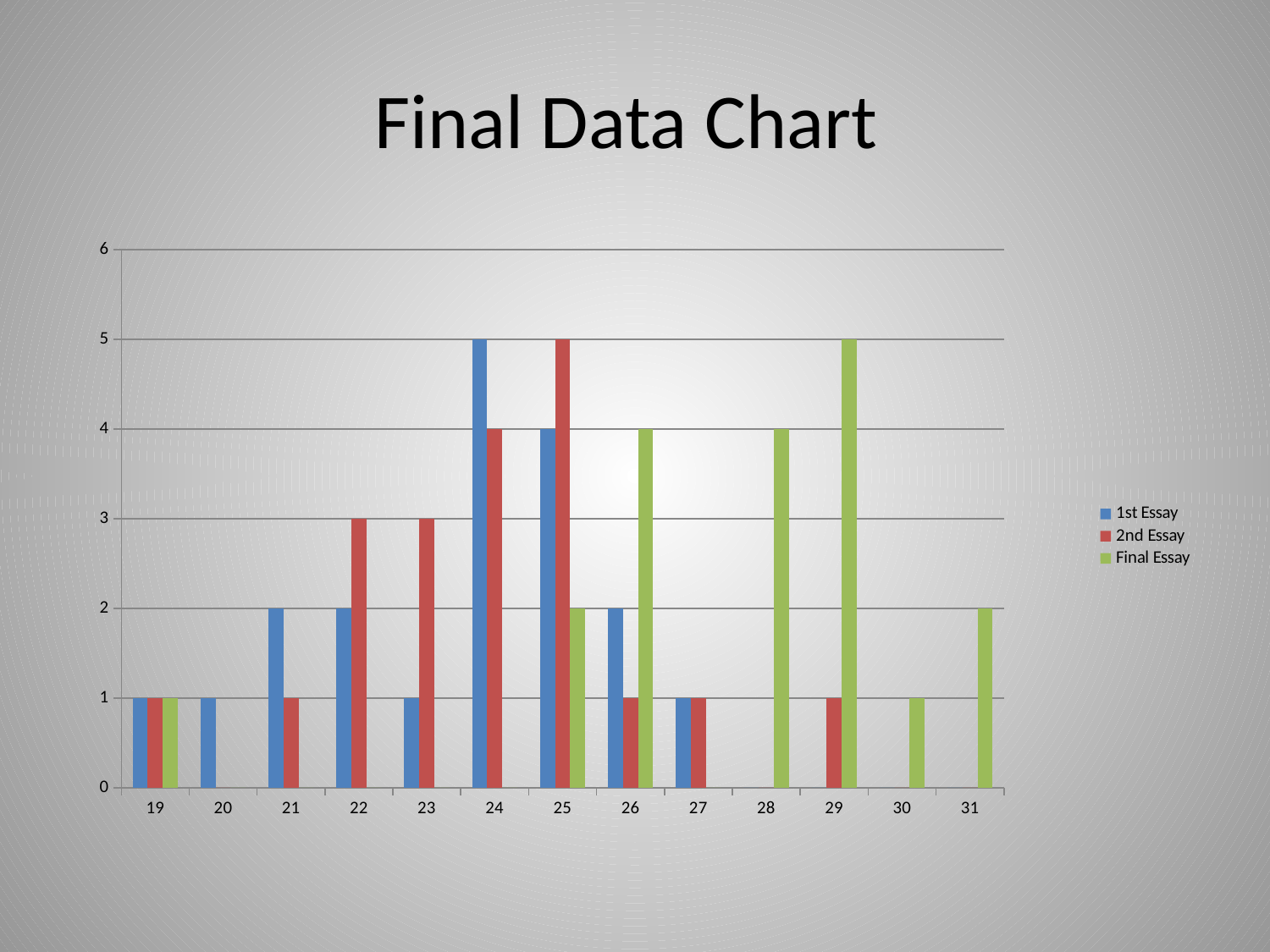
How many series does the legend list? 3 How many categories are shown on the x axis? 13 What is the value for 1st Essay at 24? 5 What kind of chart is shown on the slide? bar chart What is the difference between the Final Essay value at 28 and the Final Essay value at 30? 3 At which category is the 1st Essay value highest? 24 What is the value for Final Essay at 29? 5 Which is larger at 26: the 1st Essay value or the Final Essay value? Final Essay What is the title of the chart? Final Data Chart What is the value for 2nd Essay at 22? 3 What is the value for 2nd Essay at 25? 5 Which series is shown in green in the legend? Final Essay